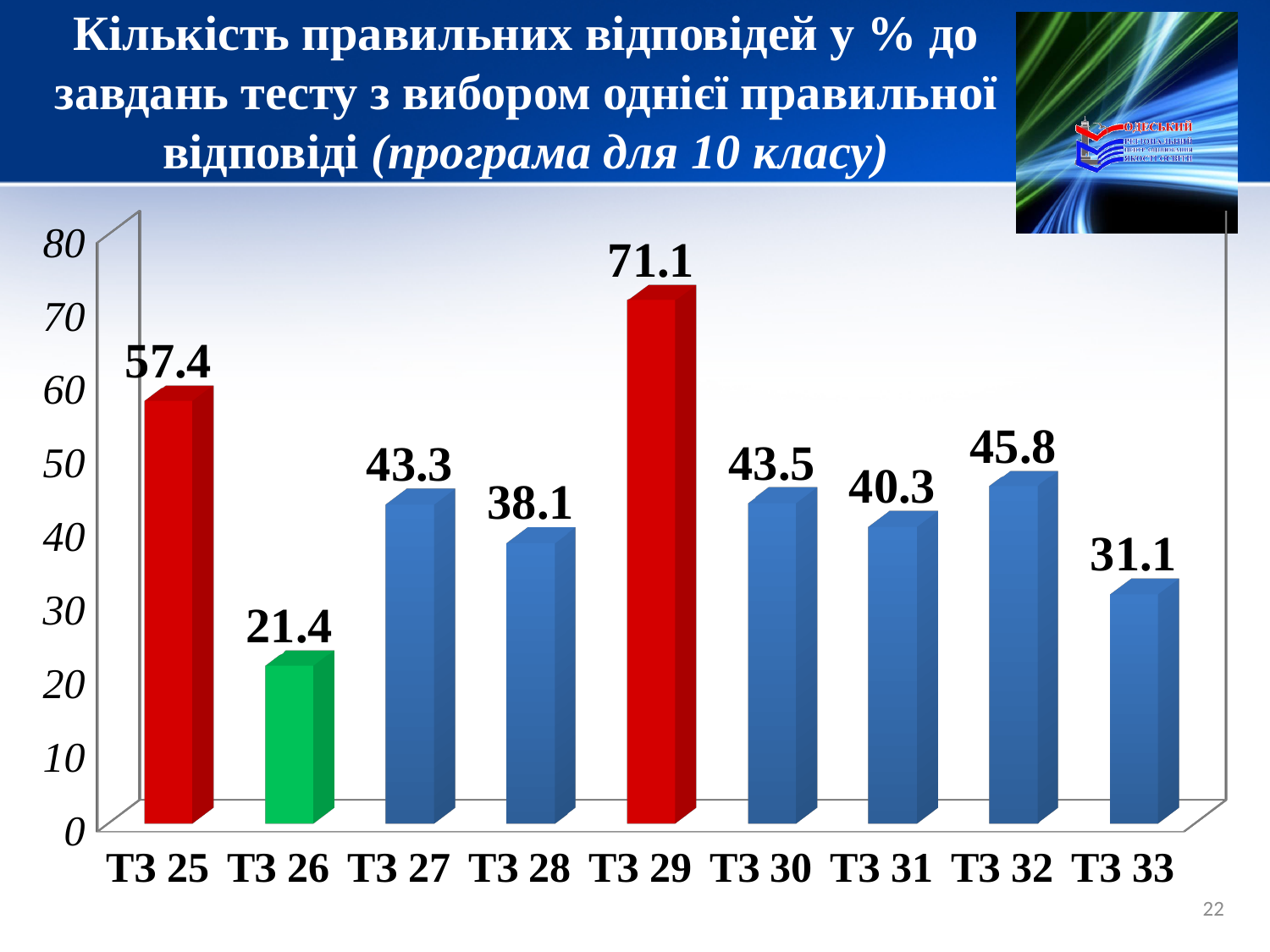
What is the difference between the values for ТЗ 25 and ТЗ 33? 26.3 How many categories are shown on the x axis? 9 Which category has the lowest value? ТЗ 26 What kind of chart is shown on the slide? bar chart What is the value for ТЗ 32? 45.8 What is the value for ТЗ 26? 21.4 What is the difference between the values for ТЗ 29 and ТЗ 26? 49.7 Is the value for ТЗ 25 greater or less than 50? greater Which bar is coloured green? ТЗ 26 Which category has the highest value? ТЗ 29 Which is larger, the value for ТЗ 28 or the value for ТЗ 31? ТЗ 31 What is the value for ТЗ 29? 71.1